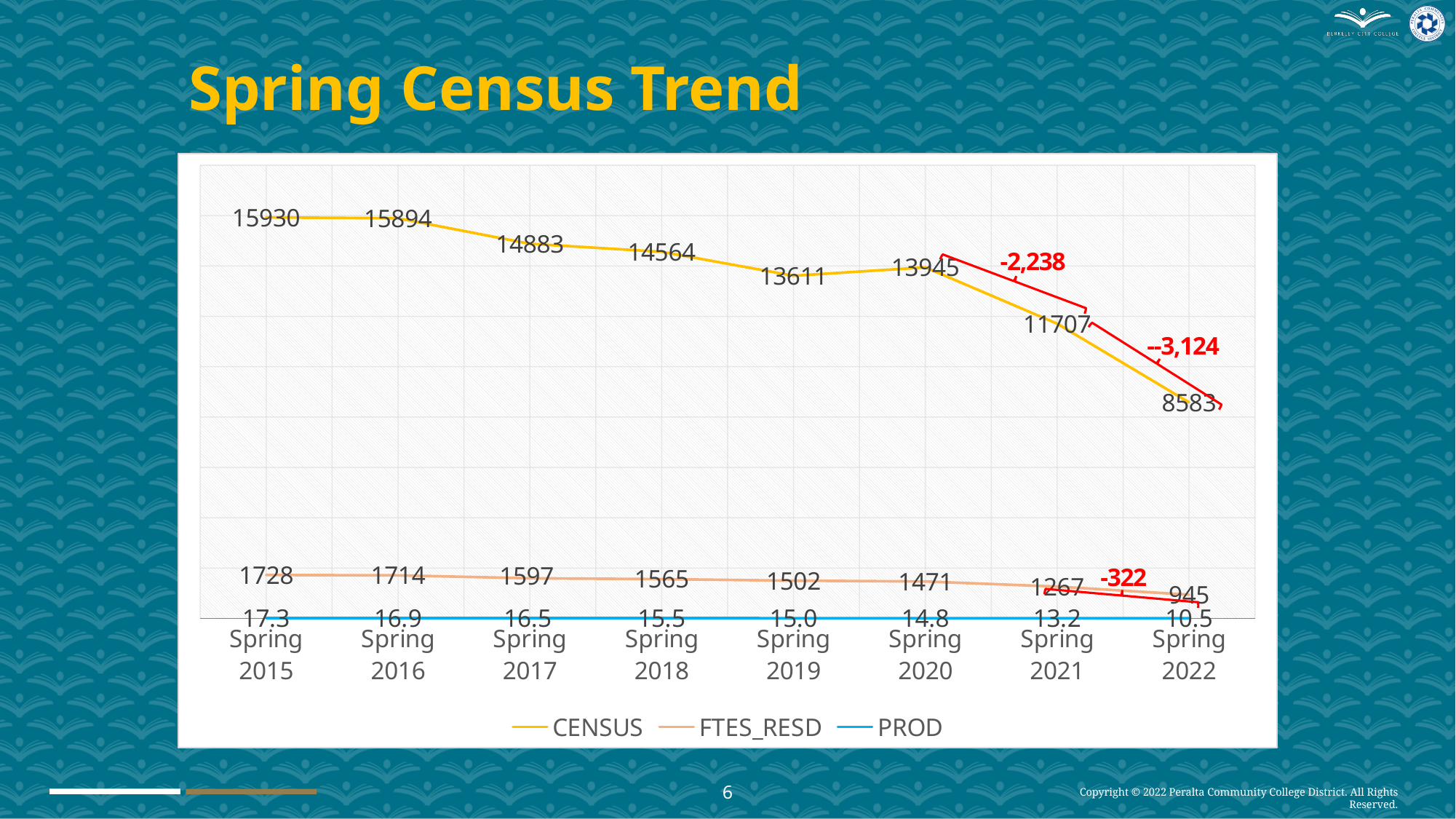
What is the PROD value for Spring 2022? 10.5 What kind of chart is shown on the slide? Line chart What is the difference between the CENSUS values for Spring 2021 and Spring 2022? 3124 How many years are shown on the x axis? 8 What is the FTES_RESD value for Spring 2019? 1502 What is the CENSUS value for Spring 2021? 11707 Does the PROD series rise or fall from Spring 2015 to Spring 2022? Fall Which is larger, the CENSUS value for Spring 2019 or for Spring 2020? Spring 2020 Which year has the lowest CENSUS value? Spring 2022 What is the CENSUS value for Spring 2015? 15930 Which year has the highest FTES_RESD value? Spring 2015 How many series does the legend list? 3